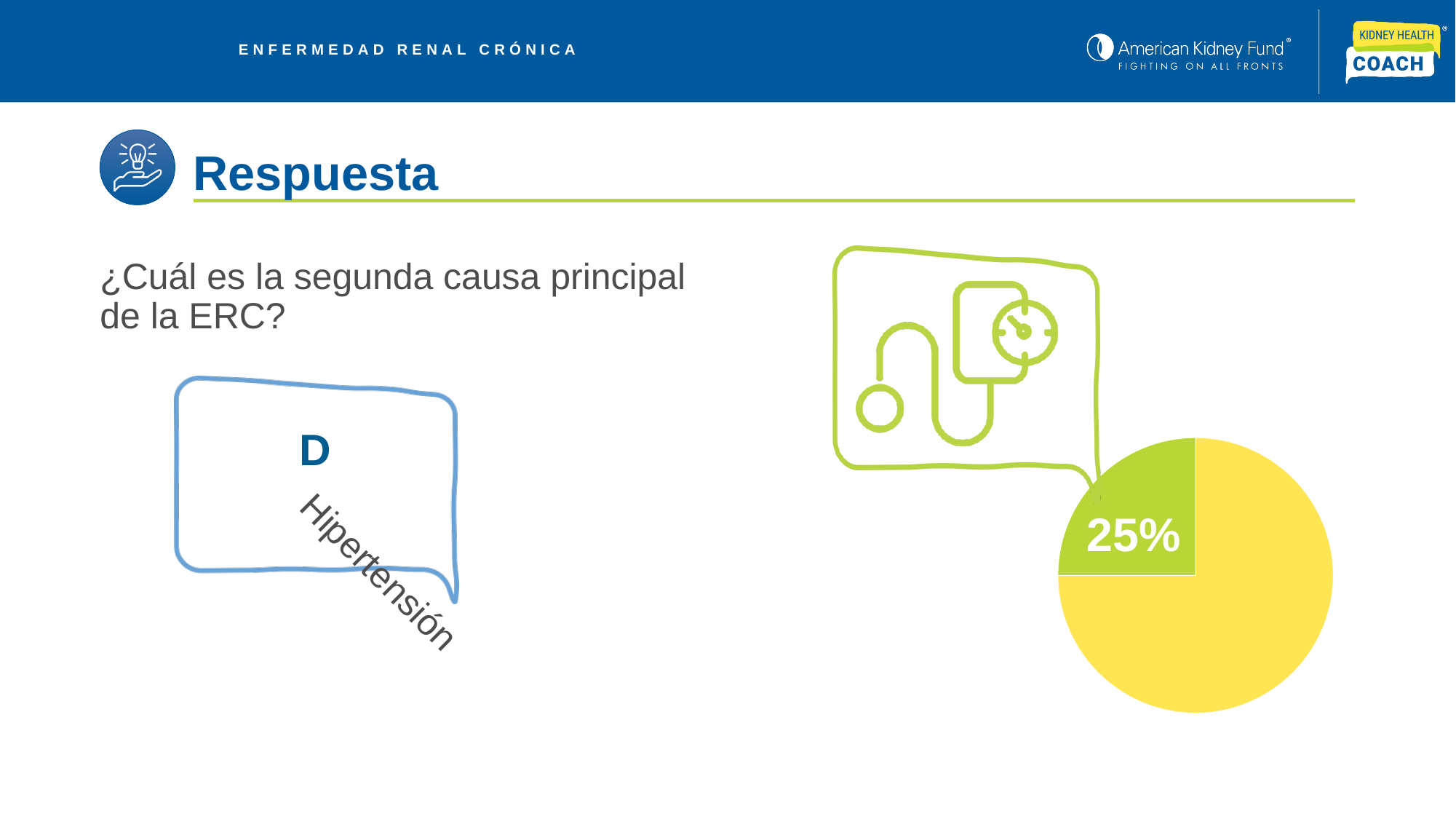
What share of the pie does the green slice represent? 25% How many slices of the pie chart have a printed data label? 1 What kind of chart is shown on the slide? pie chart Which slice of the pie chart is the largest? the yellow slice Which slice of the pie chart is larger, the green one or the yellow one? yellow Which slice of the pie chart is the smallest? the green slice How many slices does the pie chart have? 2 What percentage is printed on the green slice of the pie chart? 25% What colour is the slice labelled 25% in the pie chart? green What share of the pie does the yellow slice represent? 75%